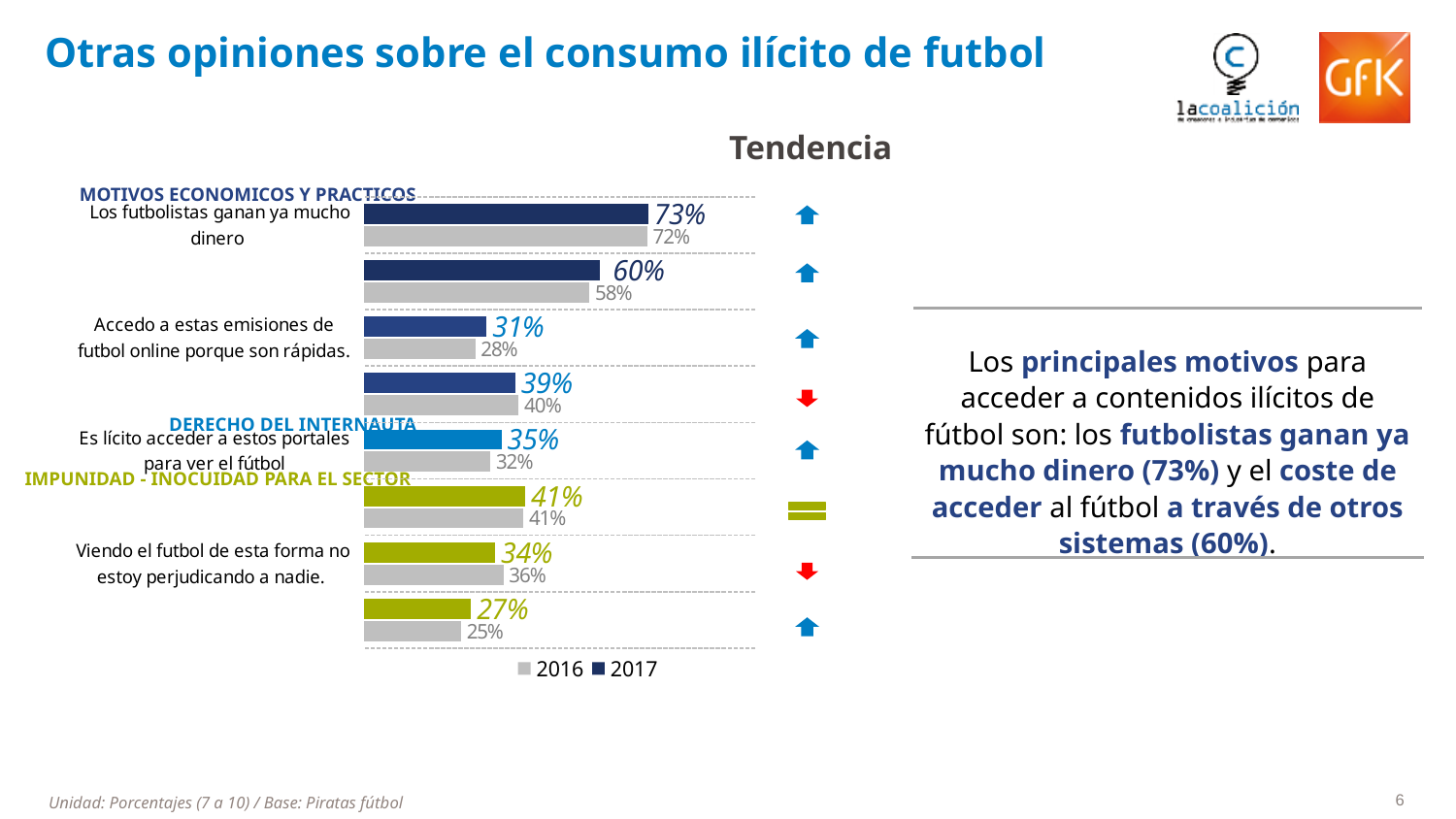
What is the 2016 value for "Es lícito acceder a estos portales para ver el fútbol"? 32% How many series does the legend list? 2 Which category has the highest 2017 value? Los futbolistas ganan ya mucho dinero What is the lowest 2017 value shown in the chart? 27% What is the difference between the 2017 and 2016 values for "Los futbolistas ganan ya mucho dinero"? 1 percentage point For "Viendo el futbol de esta forma no estoy perjudicando a nadie", which year has the larger value, 2016 or 2017? 2016 What is the 2016 value for "Viendo el futbol de esta forma no estoy perjudicando a nadie"? 36% What is the 2016 value for "Los futbolistas ganan ya mucho dinero"? 72% How many pairs of bars (categories) are plotted in the chart? 8 What is the 2017 value for "Accedo a estas emisiones de futbol online porque son rápidas"? 31% What is the 2017 value for "Los futbolistas ganan ya mucho dinero"? 73% What kind of chart is shown on the slide? Bar chart